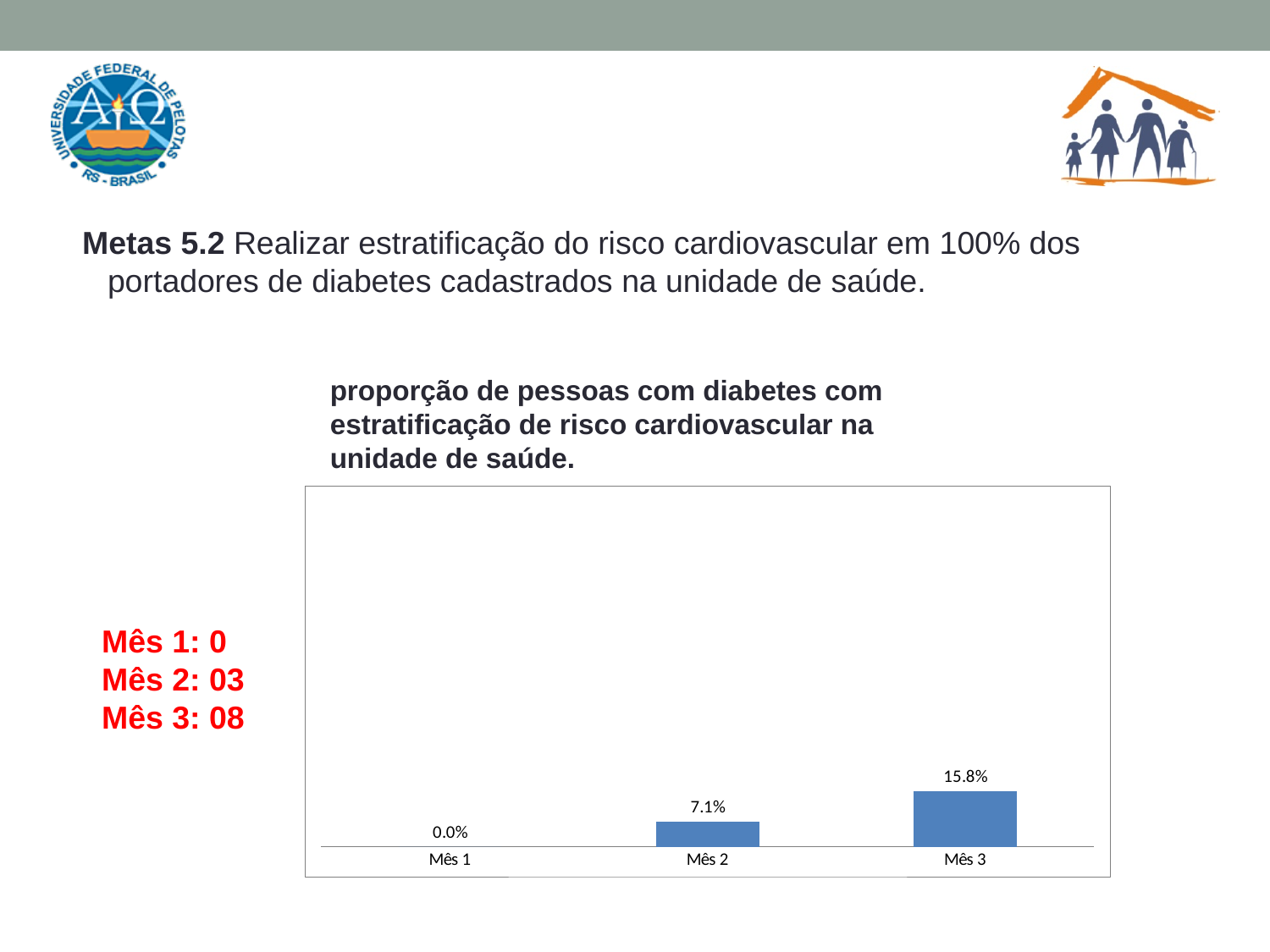
What is the value for Mês 3? 15.8% Which month has the highest value? Mês 3 What colour are the bars in the chart? Blue Which month has the lowest value? Mês 1 What kind of chart is shown on the slide? Bar chart Do the values rise or fall from Mês 1 to Mês 3? Rise What is the value for Mês 1? 0.0% What is the difference between the values for Mês 3 and Mês 2? 8.7% What is the value for Mês 2? 7.1% How many months are shown on the x axis? 3 What is the title of the chart? proporção de pessoas com diabetes com estratificação de risco cardiovascular na unidade de saúde. Which is larger, the value for Mês 2 or the value for Mês 3? Mês 3